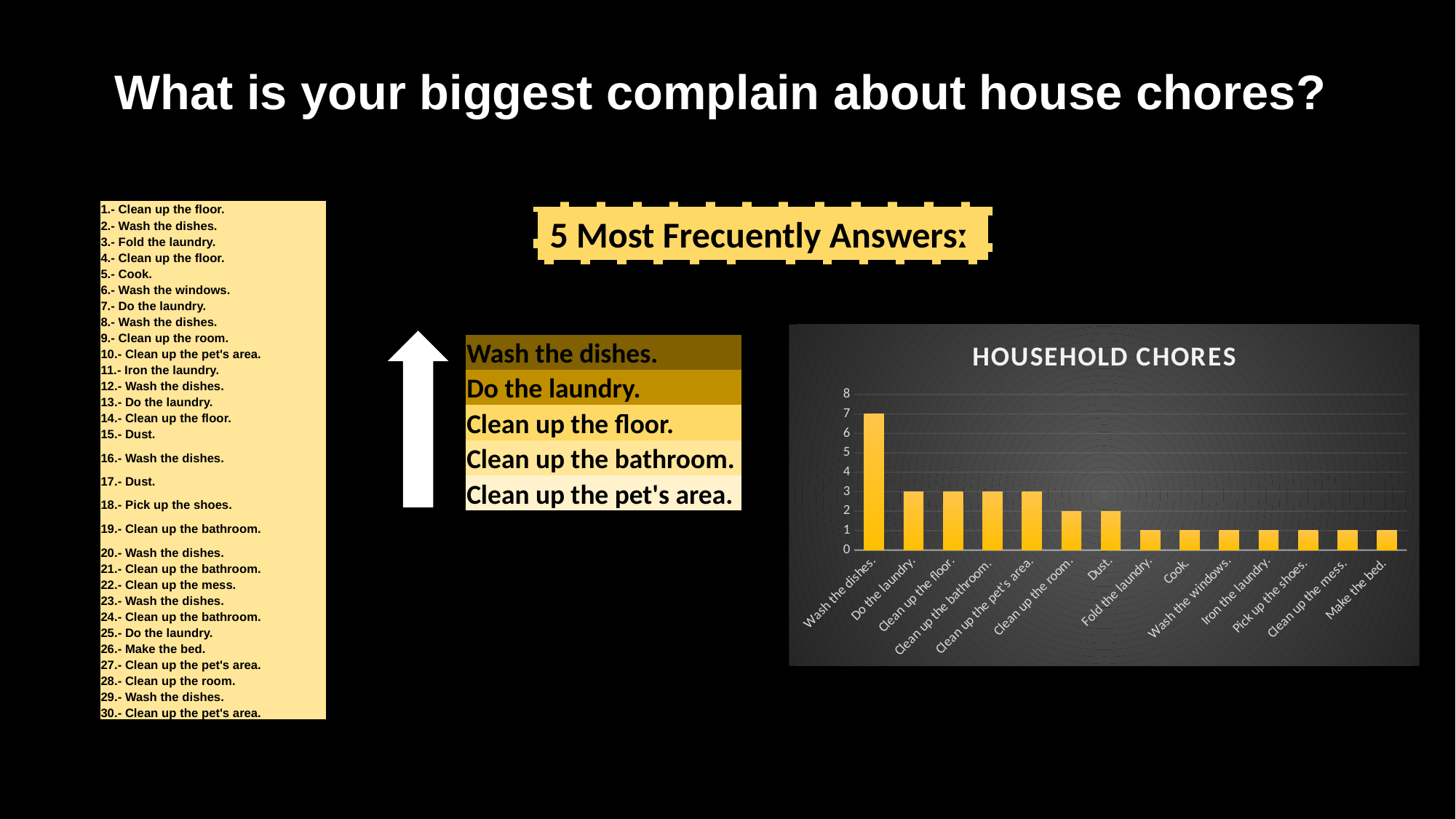
What value does the bar for "Wash the dishes." reach in the HOUSEHOLD CHORES chart? 7 In the HOUSEHOLD CHORES chart, is the value for "Wash the dishes." greater or less than 5? greater What value does the bar for "Make the bed." reach in the HOUSEHOLD CHORES chart? 1 What value does the bar for "Dust." reach in the HOUSEHOLD CHORES chart? 2 Do the bar values in the HOUSEHOLD CHORES chart generally rise or fall from left to right along the x axis? fall In the HOUSEHOLD CHORES chart, which is larger: the value for "Clean up the room." or the value for "Cook."? Clean up the room. What value does the bar for "Do the laundry." reach in the HOUSEHOLD CHORES chart? 3 What kind of chart is shown under the title "HOUSEHOLD CHORES"? bar chart In the HOUSEHOLD CHORES chart, what is the difference between the values for "Wash the dishes." and "Clean up the floor."? 4 How many categories are plotted in the HOUSEHOLD CHORES chart? 14 What is the title of the chart on the slide? HOUSEHOLD CHORES Which category has the highest bar in the HOUSEHOLD CHORES chart? Wash the dishes.